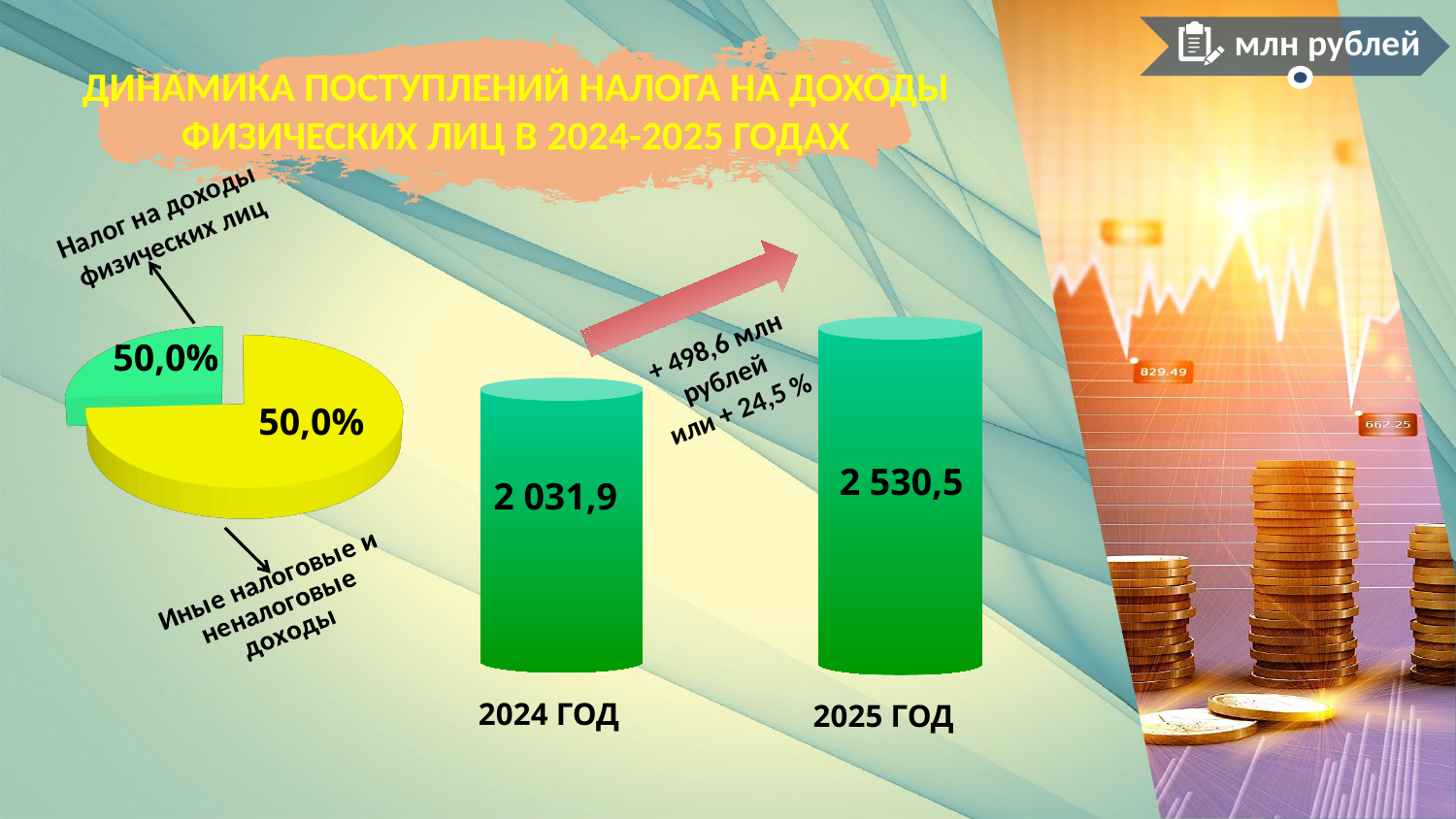
On the bar chart, do the values rise or fall from 2024 to 2025? rise On the bar chart, what is the value for 2025 ГОД? 2 530,5 On the bar chart, which year has the higher value? 2025 ГОД On the bar chart, what is the difference between the 2025 and 2024 values? 498,6 On the bar chart, how many bars are shown? 2 On the pie chart, what share is labelled for Налог на доходы физических лиц? 50,0% On the pie chart, how many slices are there? 2 On the bar chart, is the value for 2025 ГОД larger or smaller than the value for 2024 ГОД? larger What kind of chart is shown on the left side of the slide? pie chart On the bar chart, what percentage growth is stated next to the arrow? + 24,5 % On the bar chart, what is the value for 2024 ГОД? 2 031,9 On the bar chart, which year has the lower value? 2024 ГОД